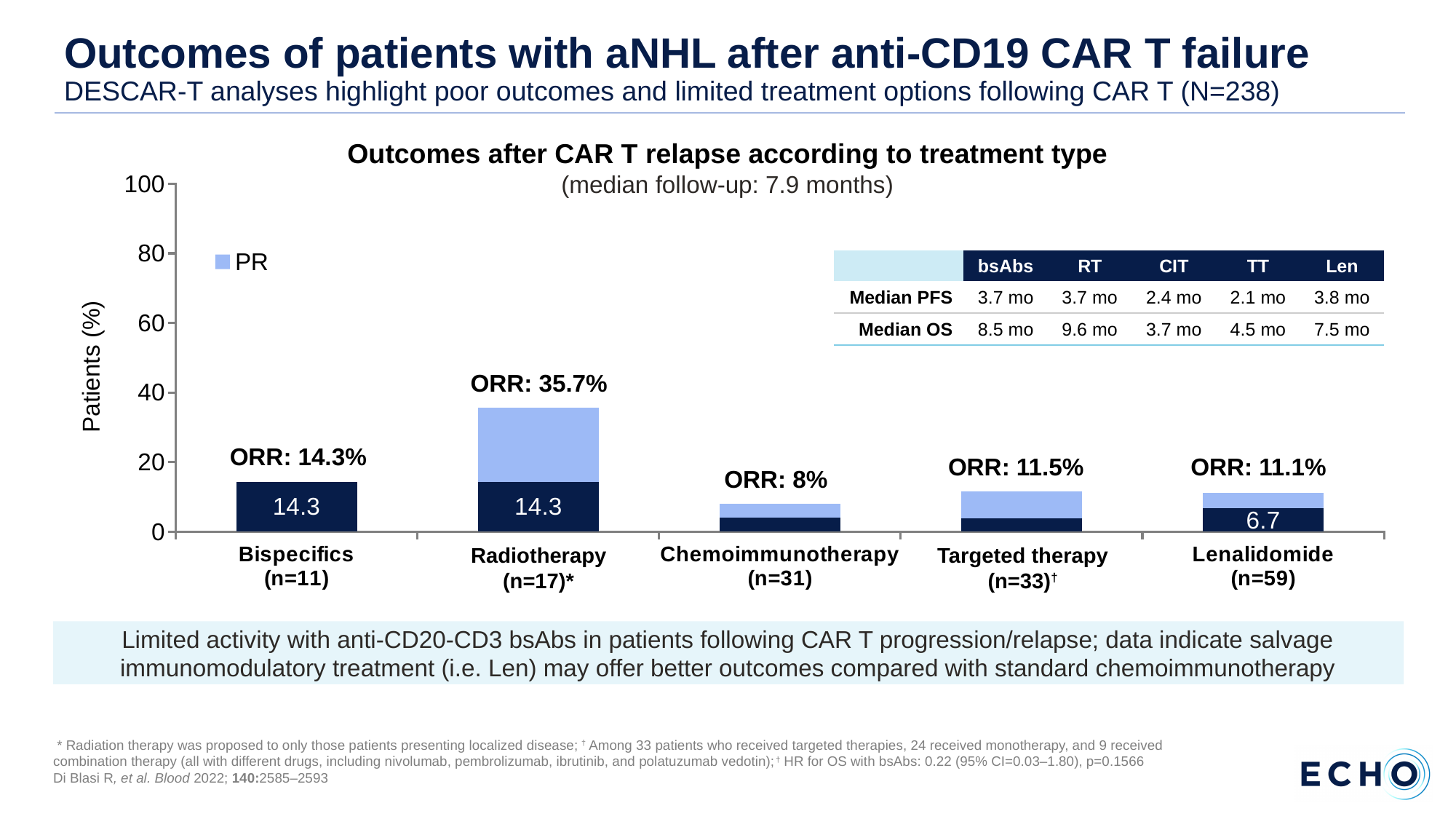
Which has the higher ORR, Targeted therapy or Lenalidomide? Targeted therapy How many treatment categories are shown on the x axis of the chart? 5 What value is printed on the dark blue segment of the Lenalidomide bar? 6.7 Which treatment type has the lowest ORR in the chart? Chemoimmunotherapy Which treatment type has the highest ORR in the chart? Radiotherapy What is the ORR shown for Chemoimmunotherapy (n=31)? 8% What value is printed on the dark blue segment of the Bispecifics bar? 14.3 What kind of chart is shown on the slide? Bar chart What is the difference between the ORR for Radiotherapy and the ORR for Bispecifics? 21.4 percentage points What is the ORR shown for Radiotherapy (n=17)? 35.7% What median follow-up is stated in the chart subtitle? 7.9 months Is the total height of the Radiotherapy bar greater or less than 20? greater